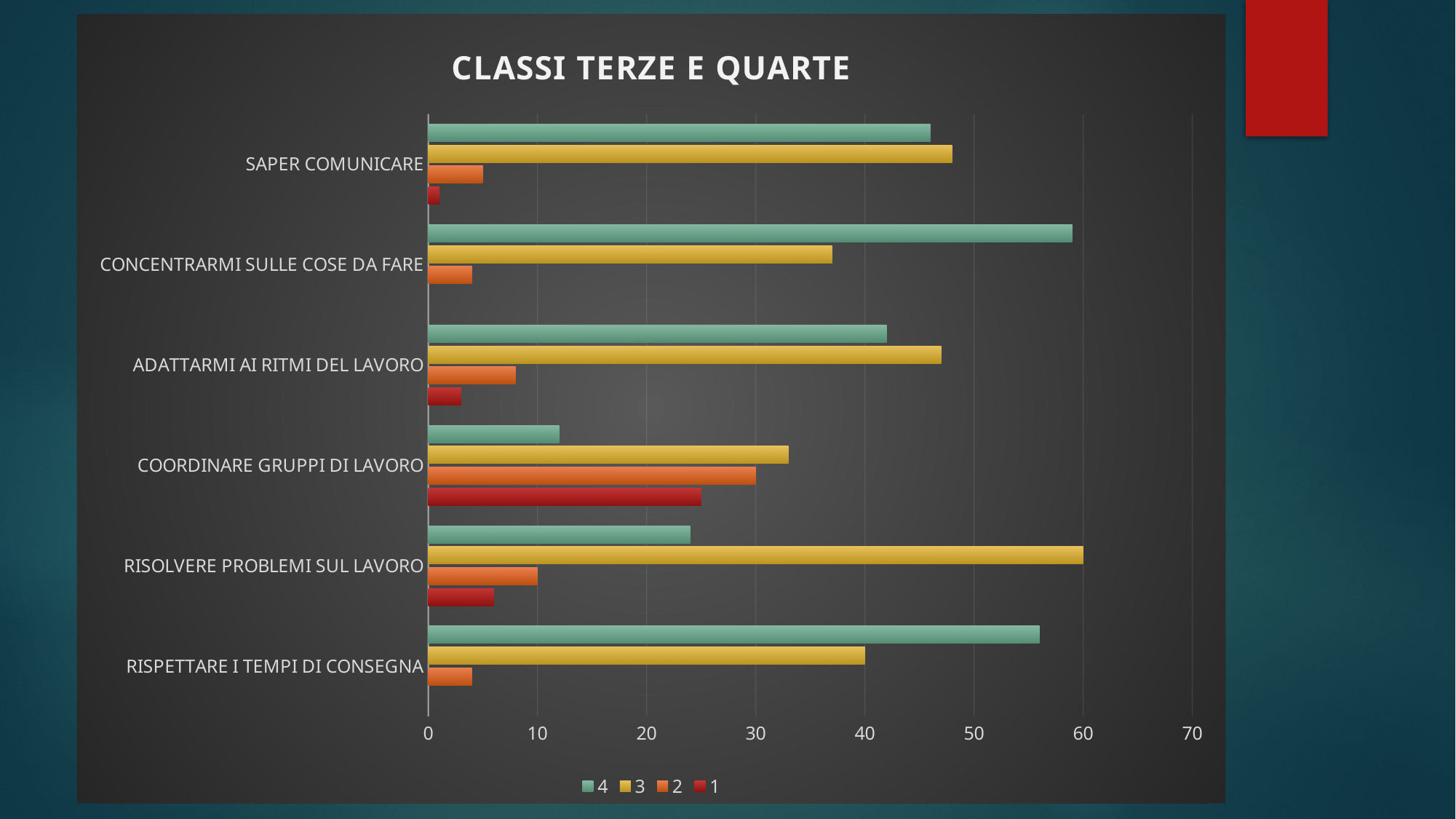
For RISOLVERE PROBLEMI SUL LAVORO, which is larger: series 3 or series 4? series 3 How many categories are shown on the vertical axis? 6 What type of chart is shown on the slide? bar chart For CONCENTRARMI SULLE COSE DA FARE, which is larger: series 4 or series 3? series 4 Is the value of series 3 for ADATTARMI AI RITMI DEL LAVORO greater or less than 40? greater Which category has the highest value for series 3? RISOLVERE PROBLEMI SUL LAVORO Is the value of series 4 for CONCENTRARMI SULLE COSE DA FARE greater or less than 50? greater How many series does the legend list? 4 Is the value of series 4 for COORDINARE GRUPPI DI LAVORO greater or less than 20? less Which category has the lowest value for series 4? COORDINARE GRUPPI DI LAVORO Which category has the highest value for series 1? COORDINARE GRUPPI DI LAVORO What is the title of the chart? CLASSI TERZE E QUARTE